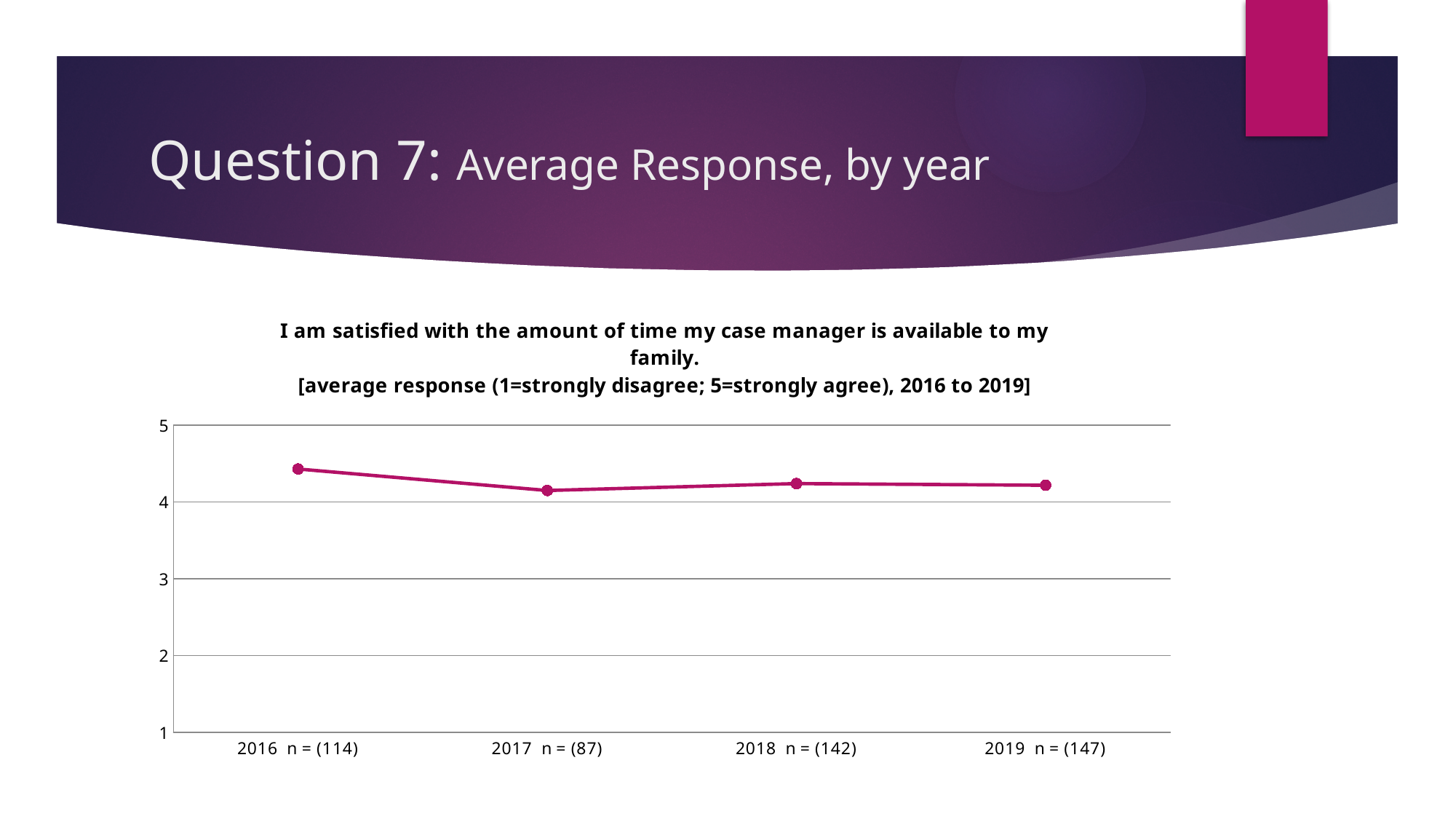
What kind of chart is shown on the slide? line chart Does the average response rise or fall from 2016 to 2017? fall Is the average response for 2018 greater or less than 3? greater What is the sample size (n) shown for 2019? 147 How many years (data points) are plotted on the chart? 4 Is the average response for 2017 greater or less than 4? greater Is the average response for 2019 greater or less than 5? less What is the lowest value shown on the vertical axis? 1 Which year has the highest average response? 2016 What is the sample size (n) shown for 2017? 87 Which is larger, the average response for 2016 or for 2017? 2016